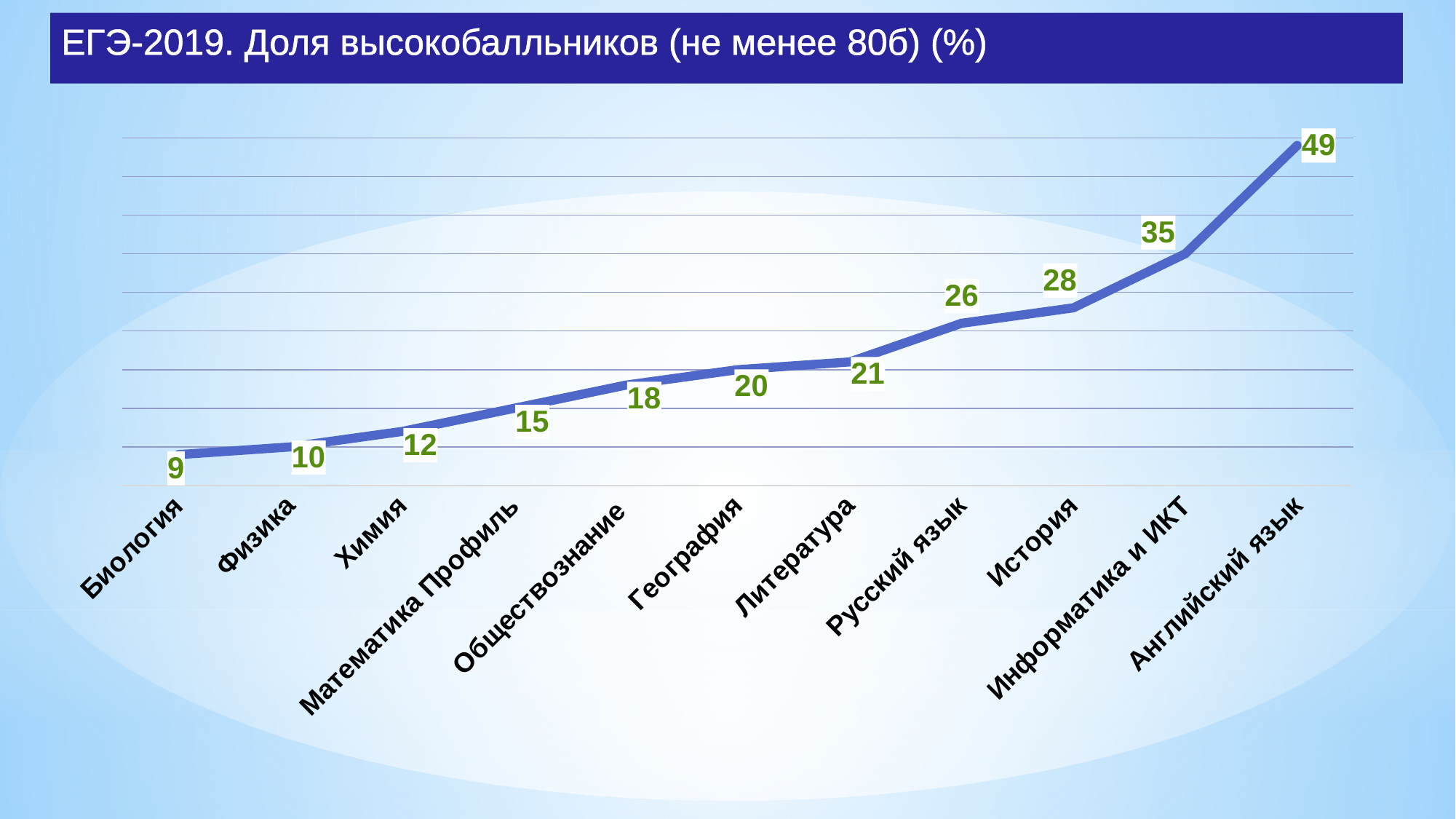
Which category has the lowest value? Биология What is the value for Русский язык? 26 What is the title of the slide? ЕГЭ-2019. Доля высокобалльников (не менее 80б) (%) Which is larger, the value for Литература or the value for География? Литература Which category has the highest value? Английский язык Do the values rise or fall from left to right along the x axis? rise What kind of chart is shown on the slide? line chart How many categories are plotted on the chart? 11 What is the value for Информатика и ИКТ? 35 What is the difference between the values for Английский язык and История? 21 What is the value for Математика Профиль? 15 What is the value for Биология? 9